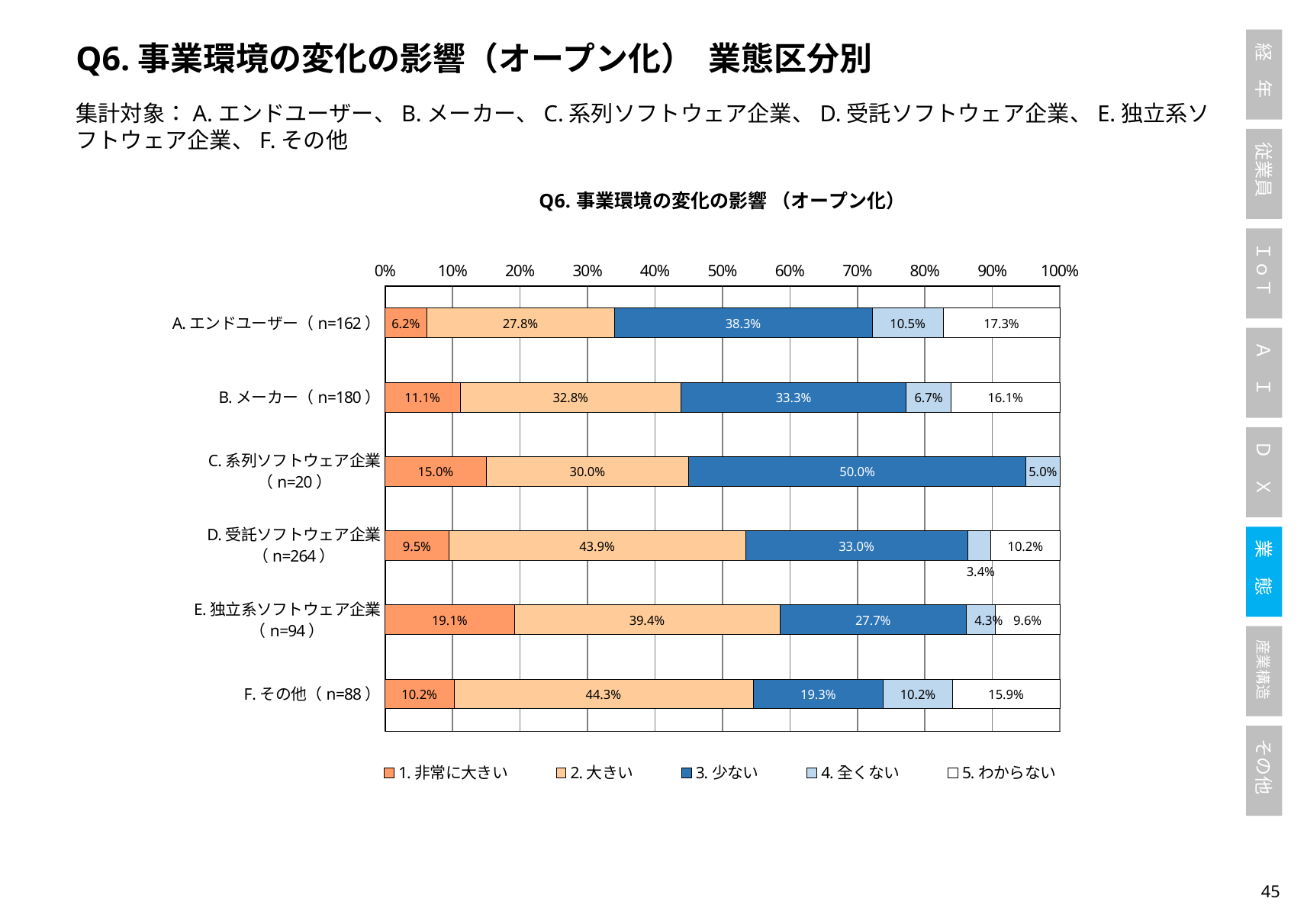
What is the sample size (n) shown for D. 受託ソフトウェア企業? 264 What is the value of 「3. 少ない」 for C. 系列ソフトウェア企業? 50.0% Which category has the highest value for 「1. 非常に大きい」? E. 独立系ソフトウェア企業 How many categories (業態区分) are plotted on the chart? 6 How many series does the legend list? 5 What is the value of 「2. 大きい」 for D. 受託ソフトウェア企業? 43.9% Which category has the lowest value for 「3. 少ない」? F. その他 What is the value of 「5. わからない」 for A. エンドユーザー? 17.3% What is the difference between the 「2. 大きい」 values for F. その他 and A. エンドユーザー? 16.5% What is the title of the chart? Q6. 事業環境の変化の影響（オープン化） Which is larger: the 「4. 全くない」 value for B. メーカー or for A. エンドユーザー? A. エンドユーザー What kind of chart is shown on the slide? Stacked bar chart